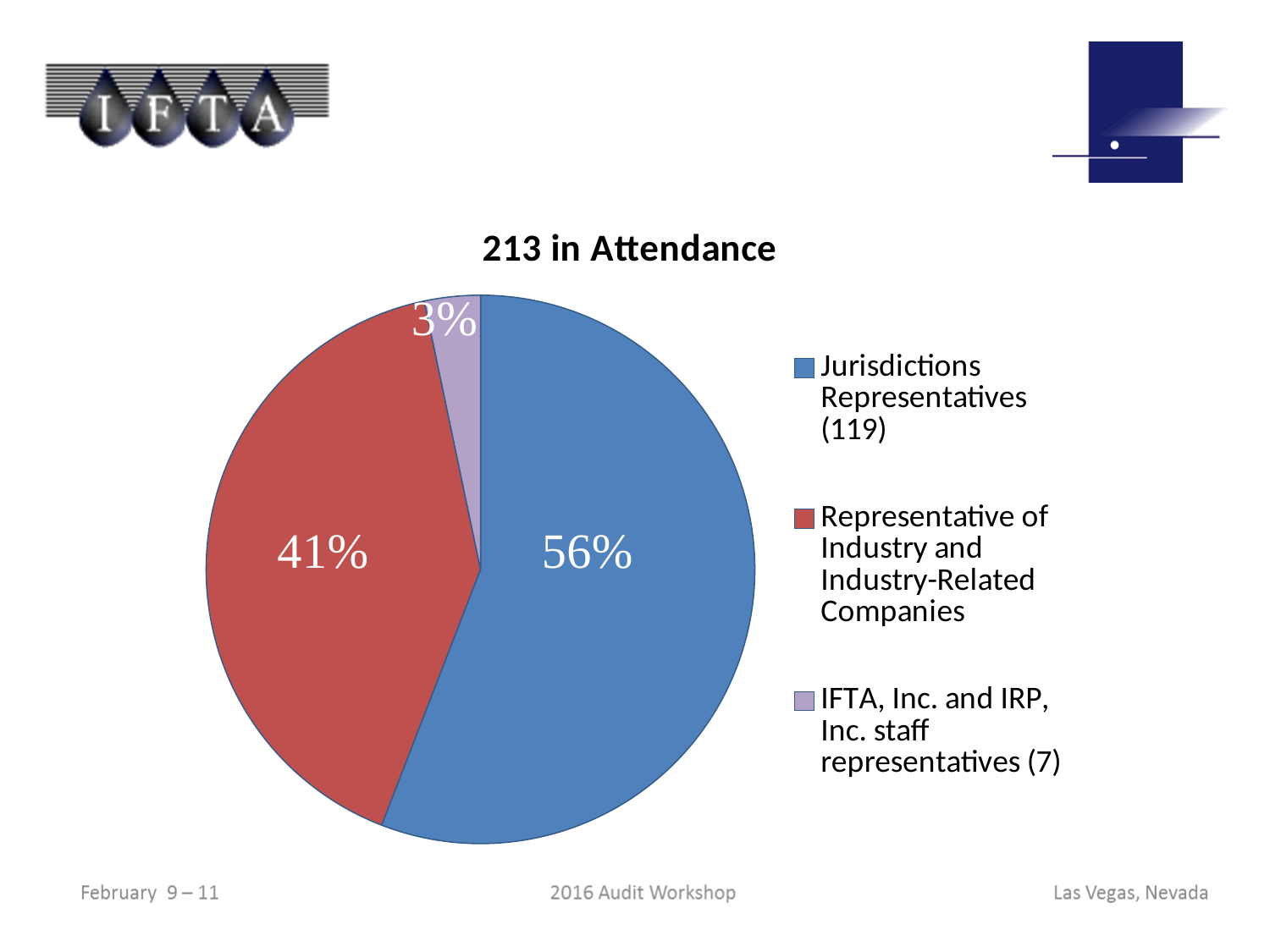
What is the difference in percentage points between the Jurisdictions Representatives slice and the Representative of Industry and Industry-Related Companies slice? 15 What colour is the Jurisdictions Representatives slice? blue What share of the pie is IFTA, Inc. and IRP, Inc. staff representatives? 3% How many entries does the legend list? 3 What kind of chart is shown on the slide? pie chart Which slice is larger: Representative of Industry and Industry-Related Companies or IFTA, Inc. and IRP, Inc. staff representatives? Representative of Industry and Industry-Related Companies What is the title of the chart? 213 in Attendance Which category has the largest slice of the pie? Jurisdictions Representatives What share of the pie is Jurisdictions Representatives? 56% How many slices does the pie chart have? 3 What share of the pie is Representative of Industry and Industry-Related Companies? 41% Which category has the smallest slice of the pie? IFTA, Inc. and IRP, Inc. staff representatives